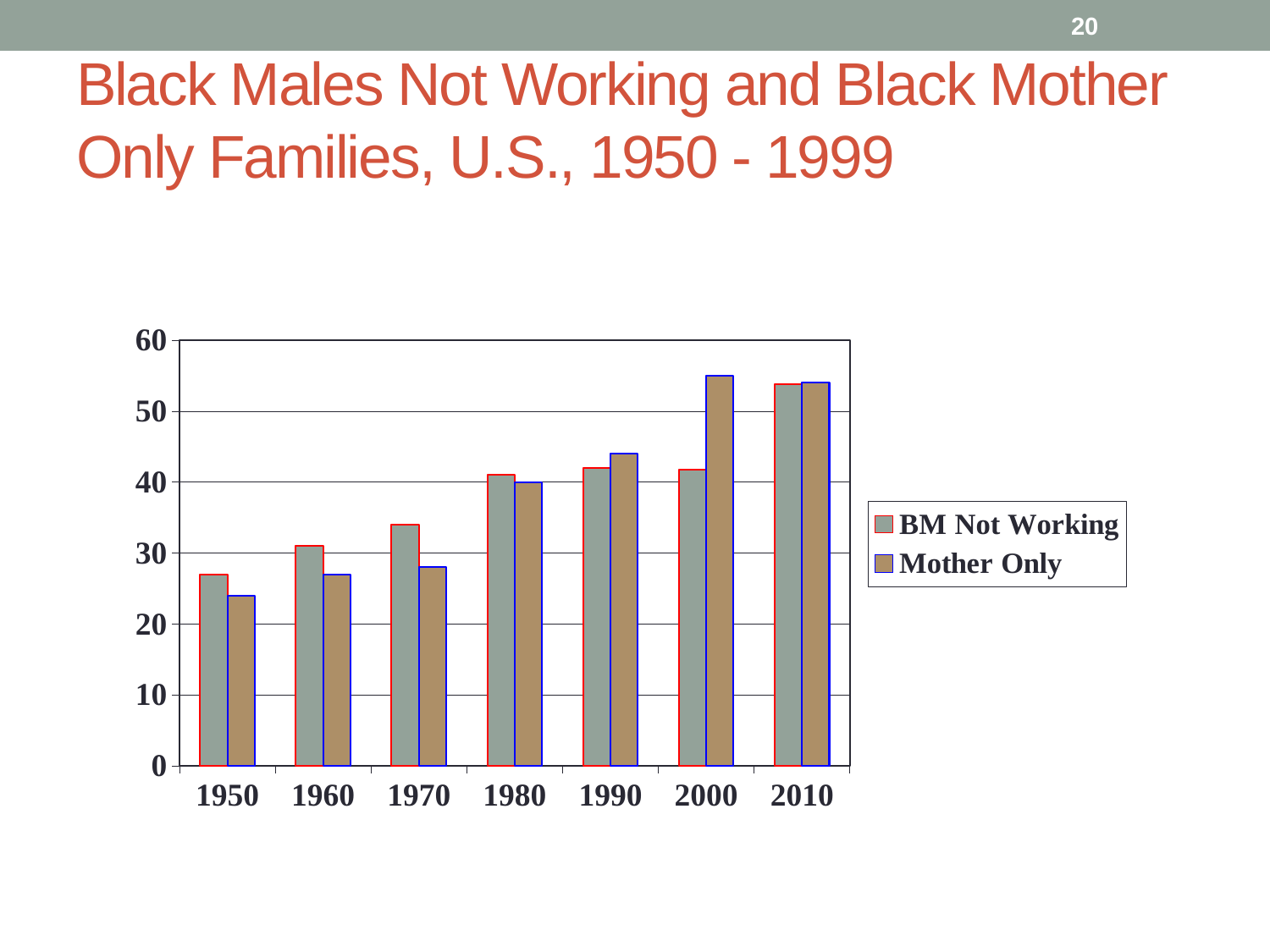
Which year has the highest value for BM Not Working? 2010 How many years are shown along the x axis? 7 In 2000, which is larger: BM Not Working or Mother Only? Mother Only What kind of chart is shown on the slide? bar chart Is the value for BM Not Working in 1970 greater or less than 30? greater Is the value for BM Not Working in 1950 greater or less than 30? less Is the value for Mother Only in 2000 greater or less than 50? greater How many series does the legend list? 2 Which year has the lowest value for Mother Only? 1950 Do the Mother Only values generally rise or fall from 1950 to 2010? rise Which year has the lowest value for BM Not Working? 1950 In 1970, which is larger: BM Not Working or Mother Only? BM Not Working